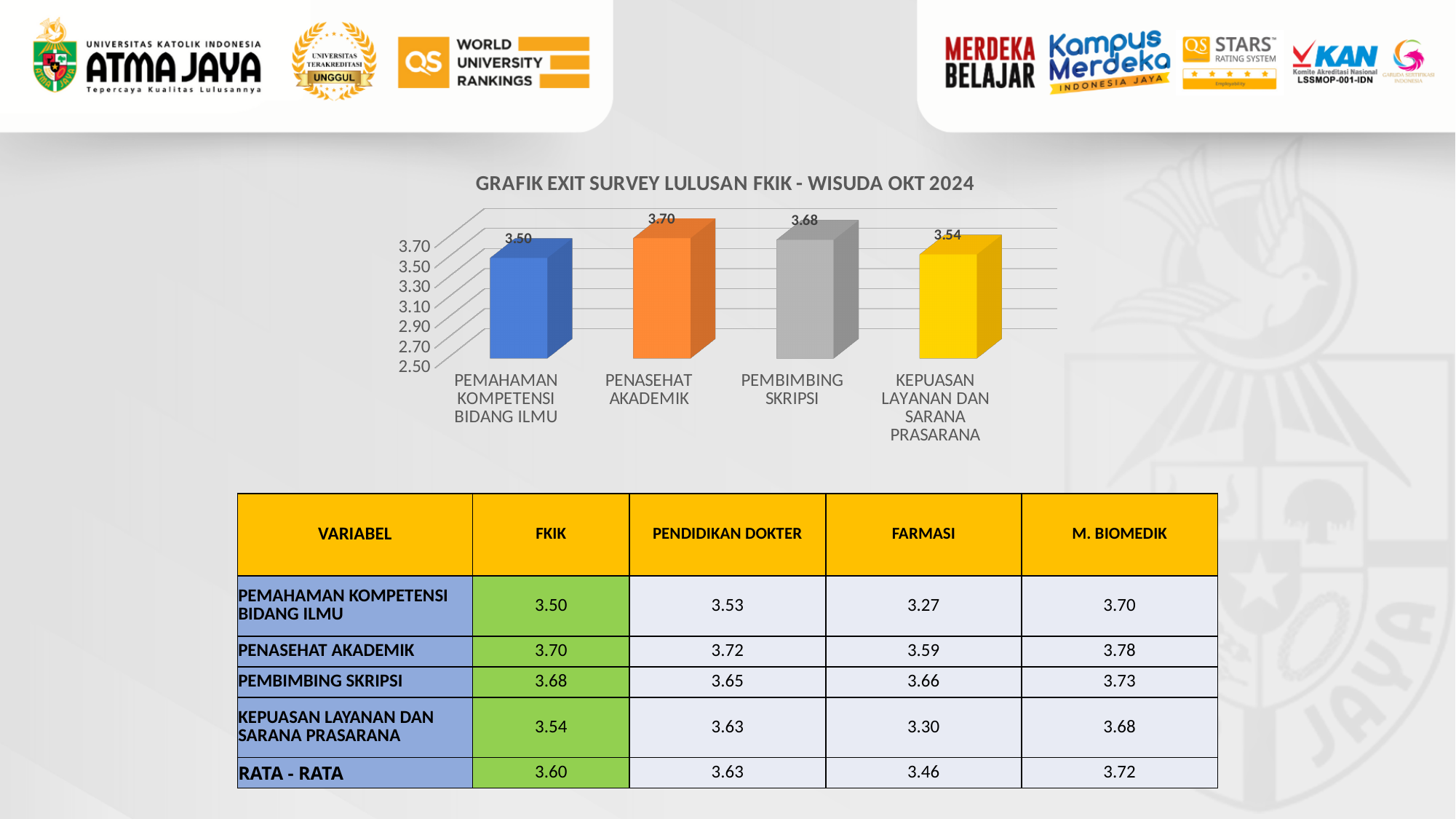
Is the value for PEMAHAMAN KOMPETENSI BIDANG ILMU greater or less than 3.30? greater Which category has the lowest value in the chart? PEMAHAMAN KOMPETENSI BIDANG ILMU Which category has the highest value in the chart? PENASEHAT AKADEMIK What is the value for KEPUASAN LAYANAN DAN SARANA PRASARANA in the chart? 3.54 Which is larger, the value for PEMBIMBING SKRIPSI or the value for KEPUASAN LAYANAN DAN SARANA PRASARANA? PEMBIMBING SKRIPSI How many categories are shown in the chart? 4 What is the difference between the values for PEMBIMBING SKRIPSI and KEPUASAN LAYANAN DAN SARANA PRASARANA? 0.14 What is the title of the chart? GRAFIK EXIT SURVEY LULUSAN FKIK - WISUDA OKT 2024 What is the value for PEMAHAMAN KOMPETENSI BIDANG ILMU in the chart? 3.50 What is the difference between the values for PENASEHAT AKADEMIK and PEMAHAMAN KOMPETENSI BIDANG ILMU? 0.20 What is the value for PENASEHAT AKADEMIK in the chart? 3.70 What is the value for PEMBIMBING SKRIPSI in the chart? 3.68